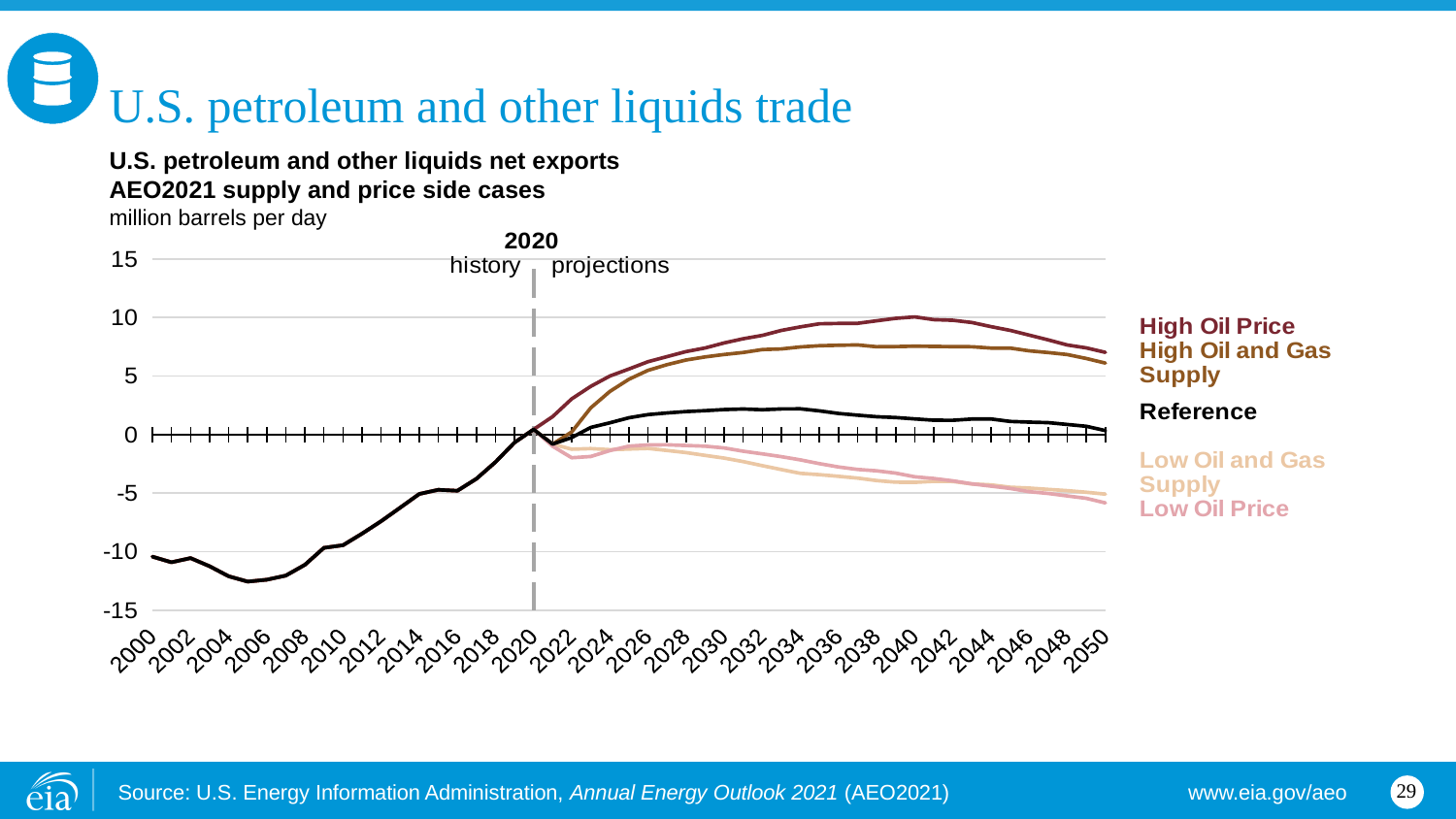
Is the value for the High Oil Price case in 2040 greater or less than 5? greater Do the historical net exports rise or fall between 2006 and 2020? rise What kind of chart is shown on the slide? line chart Does the High Oil Price case rise or fall between 2040 and 2050? fall Is the value for the Low Oil Price case in 2050 greater or less than 0? less Which year marks the boundary between history and projections on the chart? 2020 In 2040, which is larger: the High Oil Price case or the High Oil and Gas Supply case? High Oil Price How many series (cases) does the chart's legend list? 5 Is the value for the Reference case in 2050 greater or less than 5? less What unit is used for the values on the chart? million barrels per day Which case has the highest value in 2040? High Oil Price